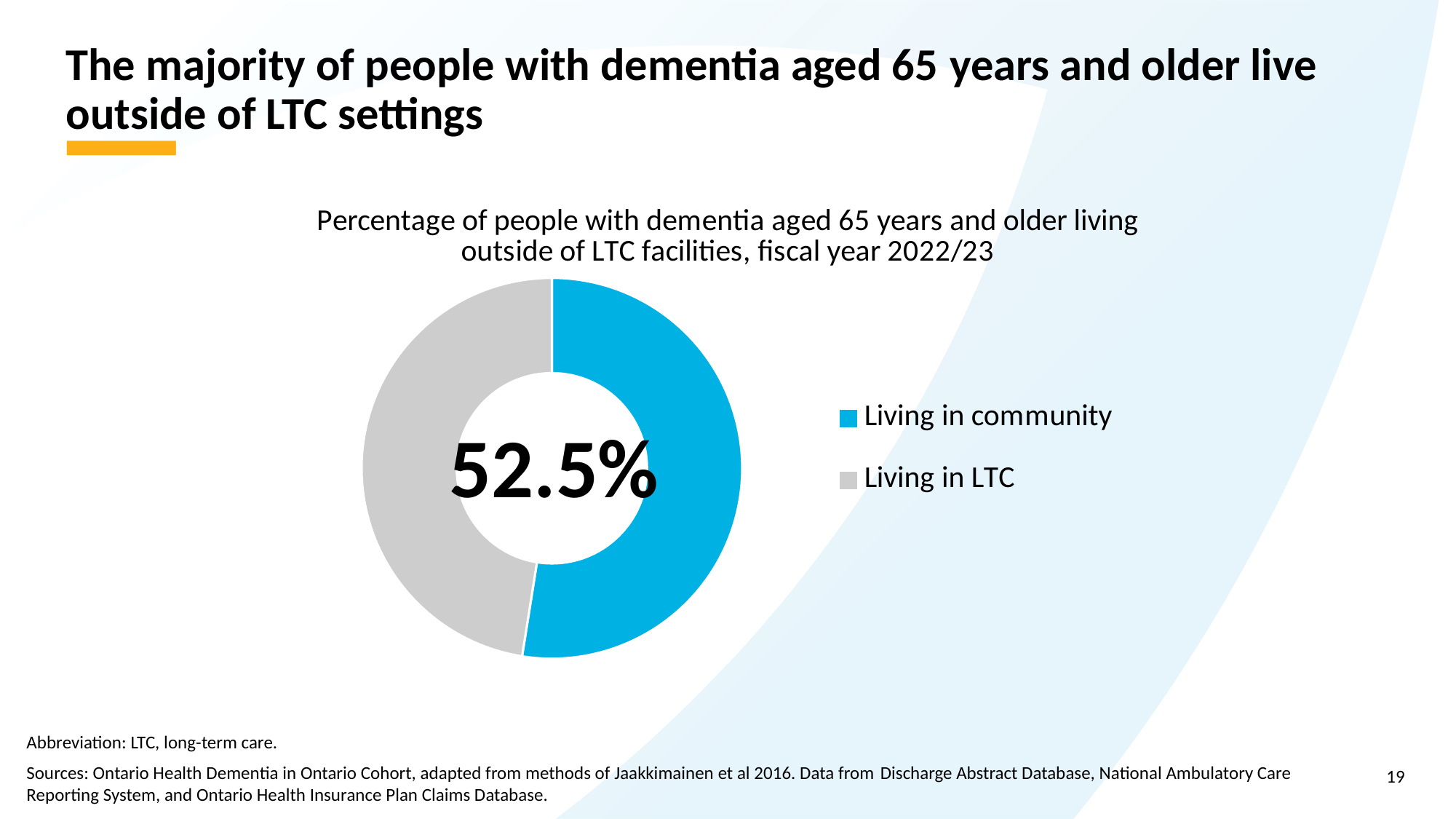
Which category makes up the larger share of the chart? Living in community How many entries does the legend list? 2 What percentage is shown in the centre of the chart for people living in community? 52.5% What kind of chart is shown on the slide? pie chart (donut) Is the share for Living in LTC greater or less than 50%? less How many categories does the chart show? 2 Which is larger: the share living in community or the share living in LTC? Living in community What colour represents Living in community in the chart? Blue Which fiscal year does the chart title say the data is for? 2022/23 What share of the pie does the Living in community slice represent? 52.5% Which category makes up the smaller share of the chart? Living in LTC Is the share for Living in community greater or less than 50%? greater